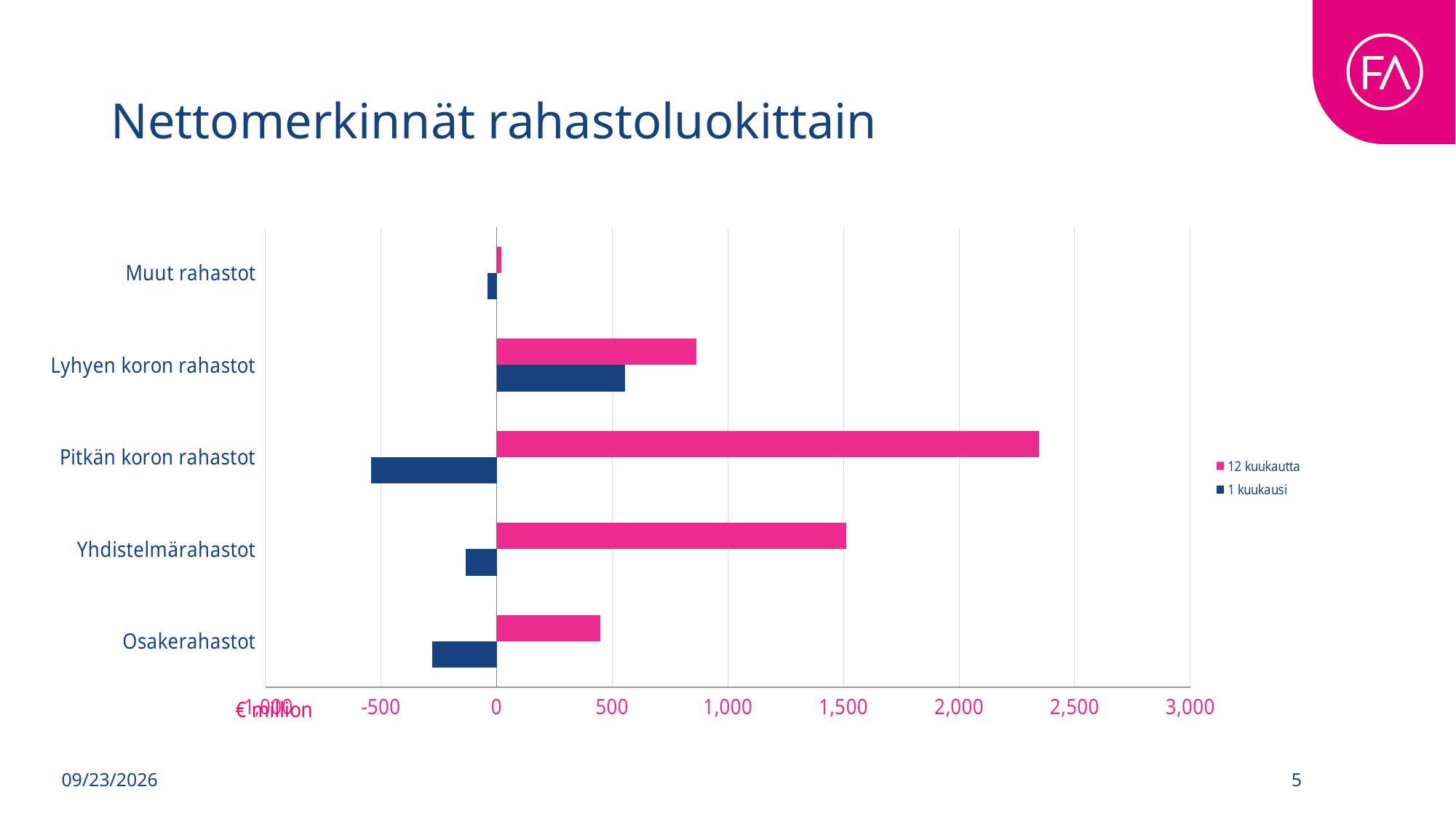
Which category has the highest value for the 1 kuukausi series? Lyhyen koron rahastot Which colour represents the 1 kuukausi series in the legend? dark blue How many series does the legend list? 2 Which category has the lowest value for the 1 kuukausi series? Pitkän koron rahastot What is the title of the chart on the slide? Nettomerkinnät rahastoluokittain Which is larger for Yhdistelmärahastot: the 12 kuukautta value or the 1 kuukausi value? 12 kuukautta Is the 12 kuukautta value for Osakerahastot greater or less than 500? less Which category has the highest value for the 12 kuukautta series? Pitkän koron rahastot Is the 1 kuukausi value for Pitkän koron rahastot greater or less than -500? less What kind of chart is shown on the slide? bar chart How many fund categories are shown on the chart? 5 Is the 12 kuukautta value for Pitkän koron rahastot greater or less than 2,000? greater